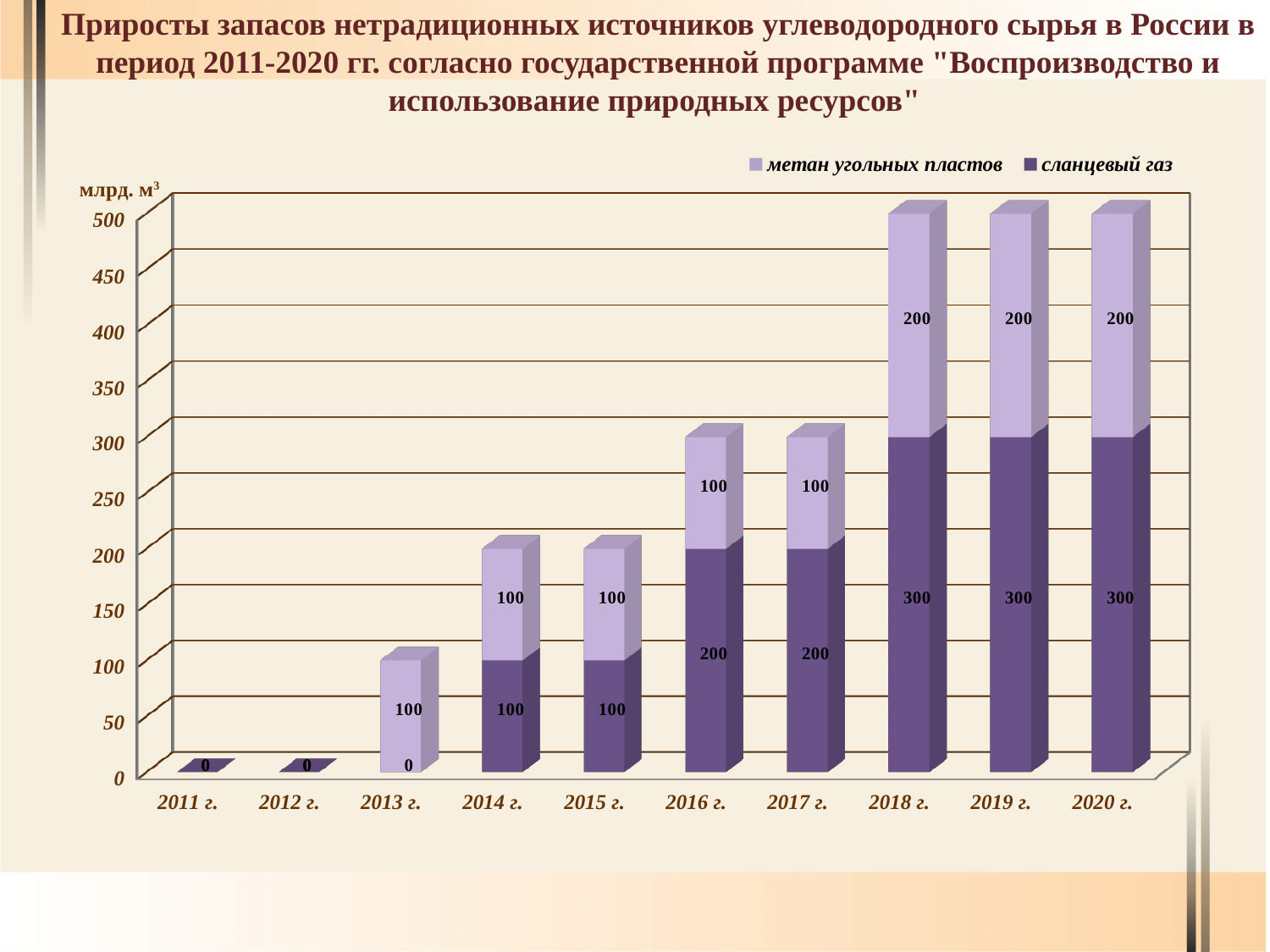
What is the total of the stacked bar for 2020 г.? 500 How many years are shown on the x axis? 10 Do the total values generally rise or fall from 2011 г. to 2020 г.? Rise What is the value for метан угольных пластов in 2016 г.? 100 What is the difference between сланцевый газ in 2019 г. and сланцевый газ in 2017 г.? 100 What type of chart is shown on the slide? Stacked bar chart What is the total of the stacked bar for 2014 г.? 200 What is the value for сланцевый газ in 2013 г.? 0 What unit is shown on the y axis? млрд. м³ How many series does the legend list? 2 What is the value for сланцевый газ in 2018 г.? 300 Which is larger in 2016 г.: сланцевый газ or метан угольных пластов? сланцевый газ